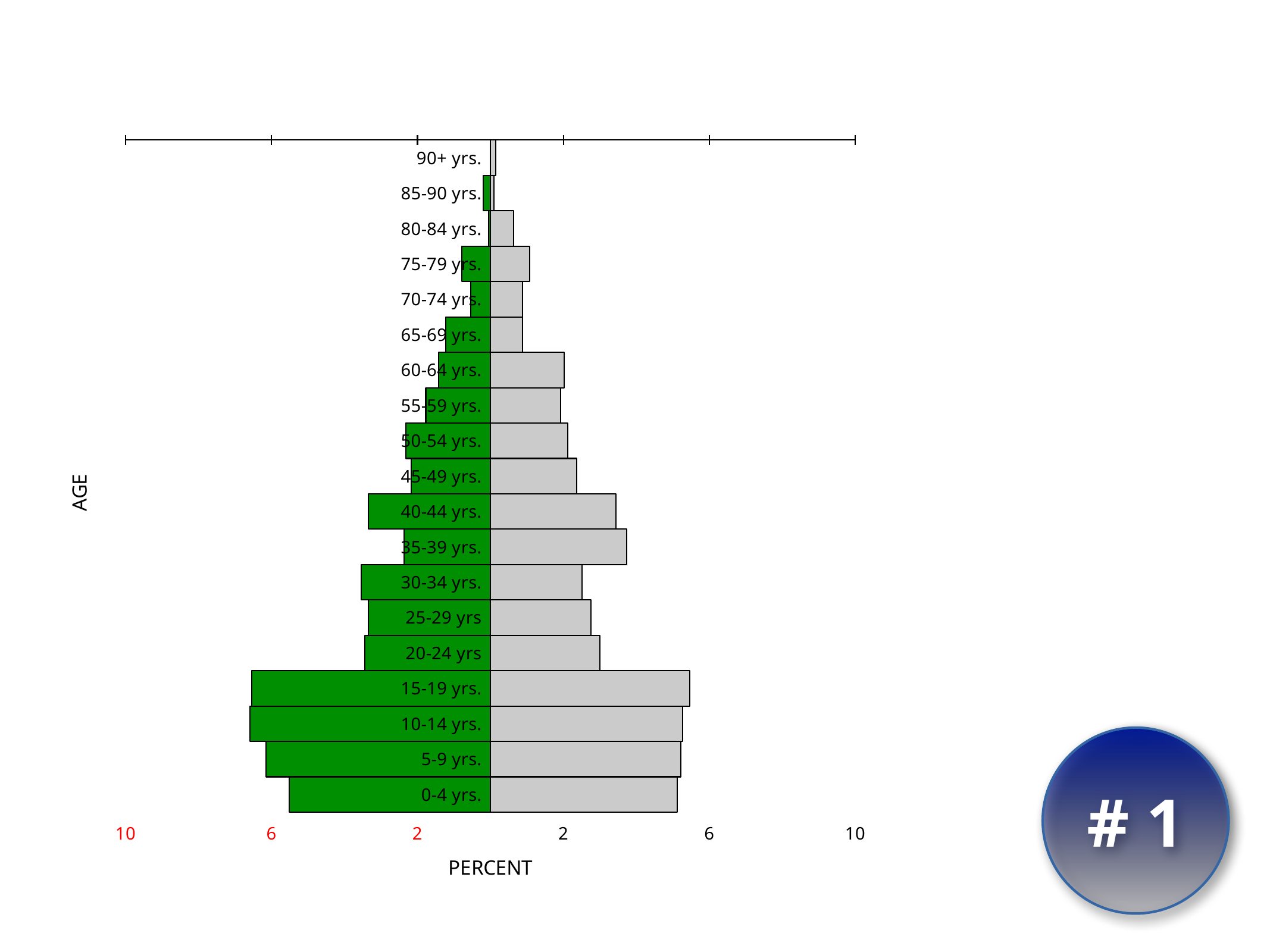
Is the green bar for 15-19 yrs. greater or less than 6? greater How many age groups are plotted on the chart? 19 What kind of chart is shown on the slide? bar chart Which is larger, the grey bar for 35-39 yrs. or the grey bar for 30-34 yrs.? 35-39 yrs. Is the green bar for 40-44 yrs. greater or less than 2? greater Is the grey bar for 80-84 yrs. greater or less than 2? less What is the title of the horizontal axis? PERCENT What is the title of the vertical axis? AGE Which is larger, the green bar for 15-19 yrs. or the green bar for 0-4 yrs.? 15-19 yrs.